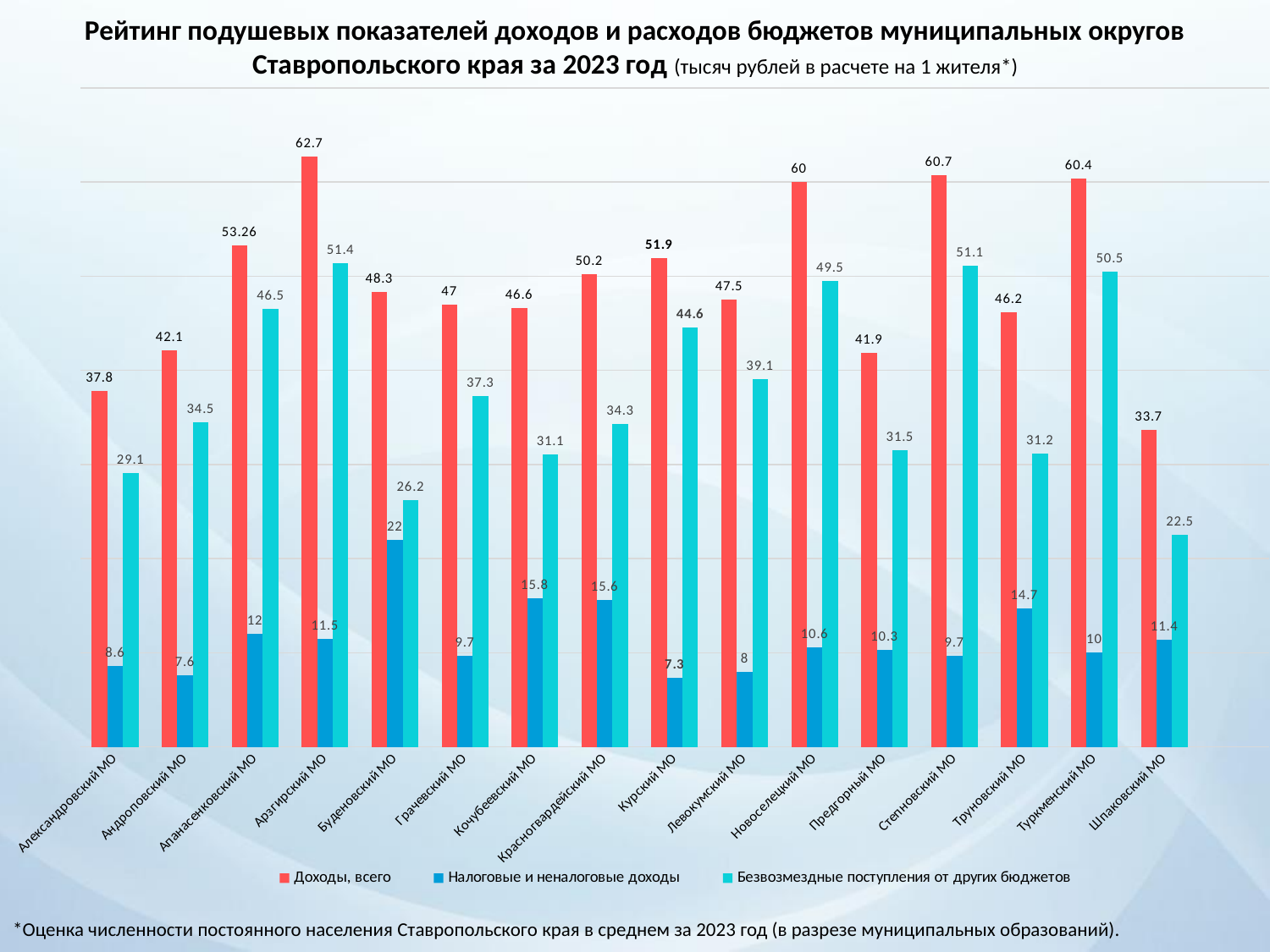
Which is larger: «Доходы, всего» for Новоселецкий МО or for Предгорный МО? Новоселецкий МО Which municipal district has the lowest value of «Доходы, всего»? Шпаковский МО Which series is shown in red? Доходы, всего What type of chart is shown on the slide? Bar chart Which municipal district has the highest value of «Доходы, всего»? Арзгирский МО How many municipal districts are shown on the x axis? 16 Which municipal district has the lowest value of «Налоговые и неналоговые доходы»? Курский МО What is the value of «Безвозмездные поступления от других бюджетов» for Курский МО? 44.6 How many series does the legend list? 3 What is the value of «Доходы, всего» for Арзгирский МО? 62.7 What is the value of «Налоговые и неналоговые доходы» for Буденновский МО? 22 What is the difference between «Доходы, всего» for Арзгирский МО and for Шпаковский МО? 29